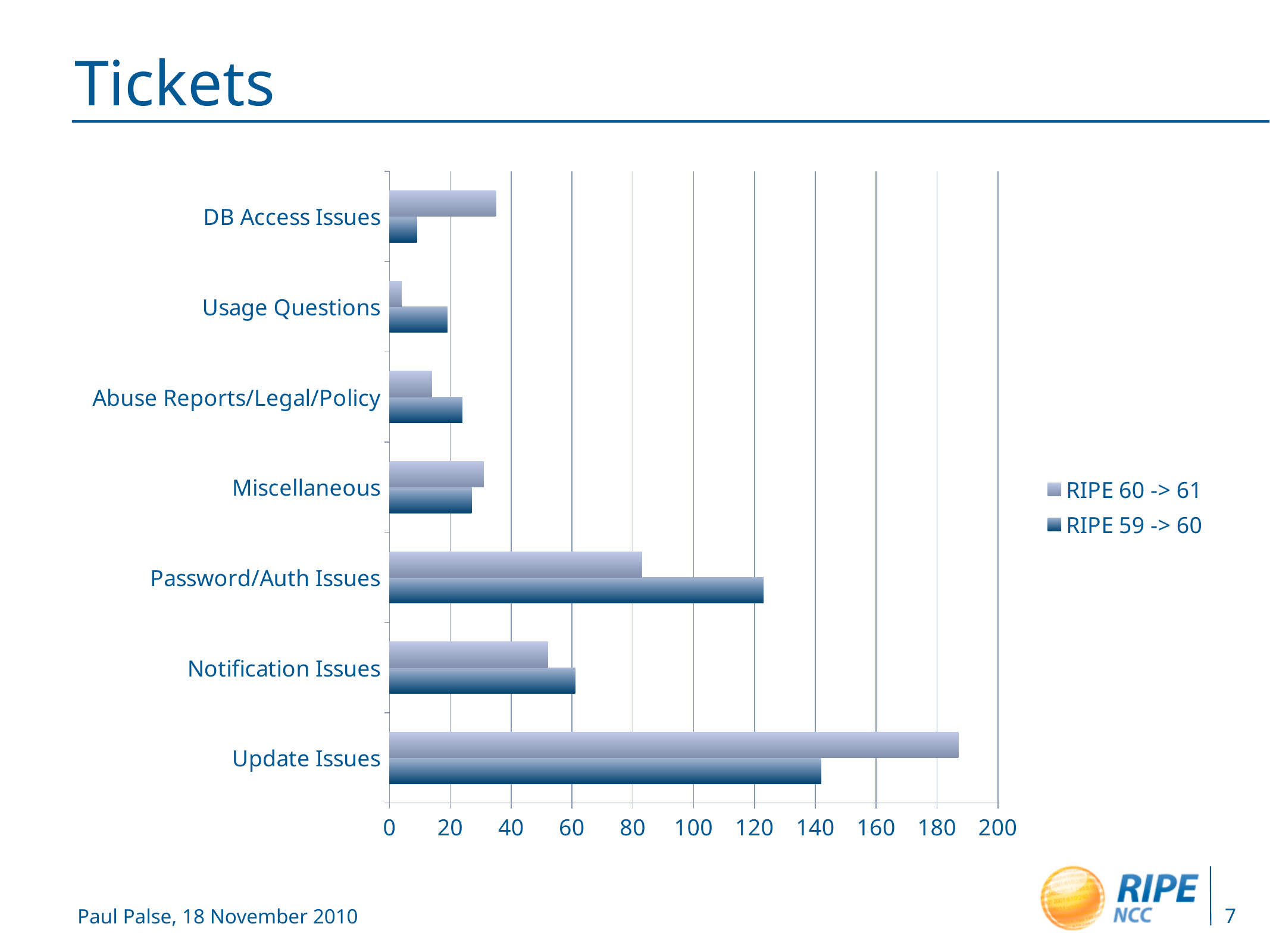
Is the RIPE 59 -> 60 value for Password/Auth Issues greater or less than 100? greater For Password/Auth Issues, which series has the larger value, RIPE 60 -> 61 or RIPE 59 -> 60? RIPE 59 -> 60 How many series does the legend list? 2 What kind of chart is shown on the slide? bar chart Is the RIPE 60 -> 61 value for Update Issues greater or less than 180? greater Which category has the highest value for the RIPE 60 -> 61 series? Update Issues How many categories are shown on the chart? 7 Which category has the lowest value for the RIPE 59 -> 60 series? DB Access Issues Which series is shown in the lighter blue colour in the legend? RIPE 60 -> 61 Which category has the highest value for the RIPE 59 -> 60 series? Update Issues Which category has the lowest value for the RIPE 60 -> 61 series? Usage Questions For Update Issues, which series has the larger value, RIPE 60 -> 61 or RIPE 59 -> 60? RIPE 60 -> 61